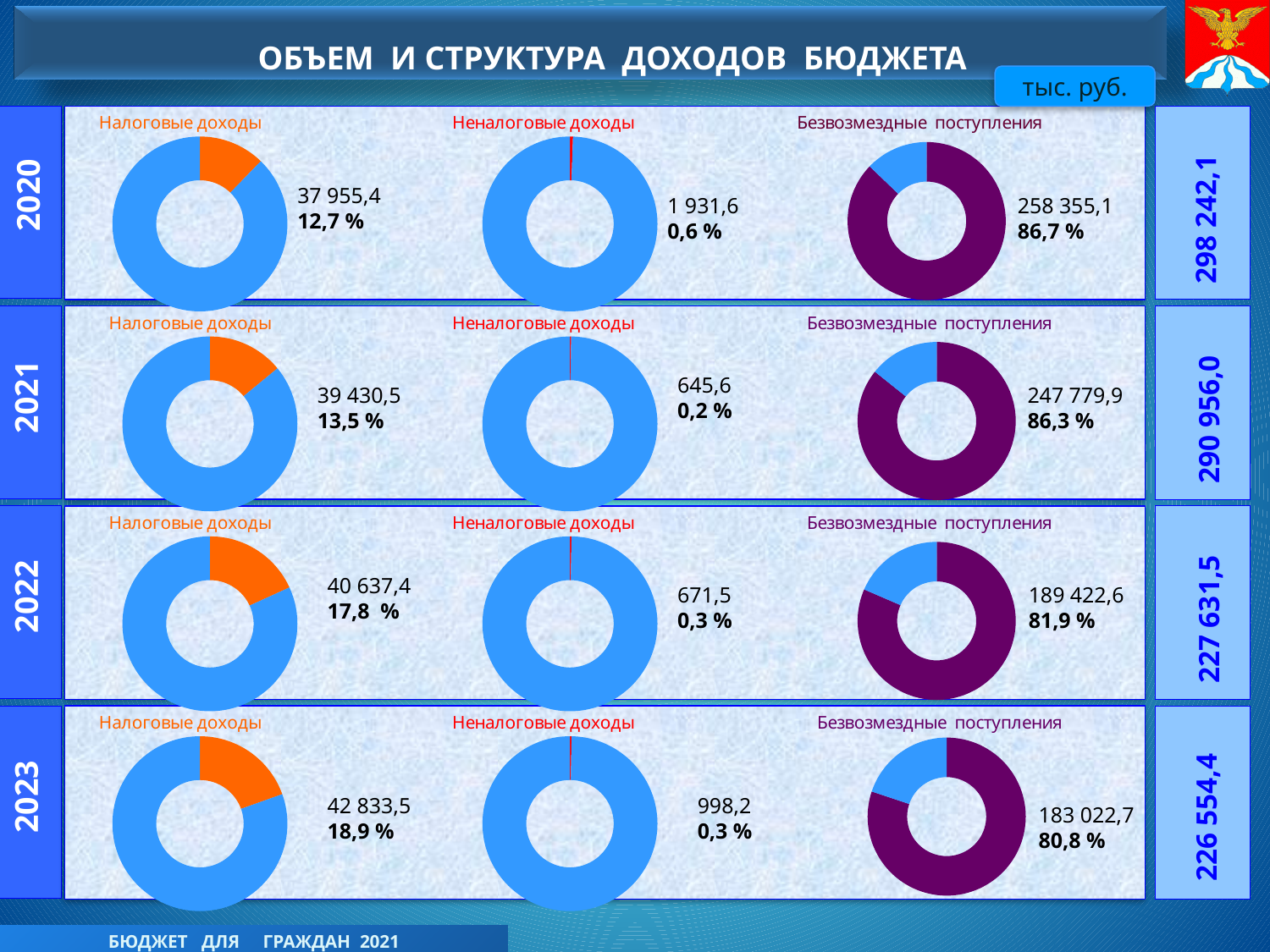
How does the 'Безвозмездные поступления' percentage share change from 2020 to 2023? It falls On the 2020 'Налоговые доходы' chart, what value is printed next to the donut? 37 955,4 What is the difference between the 'Налоговые доходы' values for 2021 and 2020? 1 475,1 Which is larger: the 'Безвозмездные поступления' value for 2020 or for 2021? 2020 On the 2021 'Неналоговые доходы' chart, what value is printed? 645,6 How many donut charts are shown on the slide? 12 What kind of chart is used for each of the income categories on the slide? Donut (pie) chart Which year's 'Неналоговые доходы' chart shows the lowest percentage share? 2021 On the 2020 'Налоговые доходы' chart, what percentage share is shown? 12,7 % Which year's 'Налоговые доходы' chart shows the highest percentage share? 2023 On the 2022 'Безвозмездные поступления' chart, what percentage share is shown? 81,9 % On the 2023 'Безвозмездные поступления' chart, what value is printed? 183 022,7